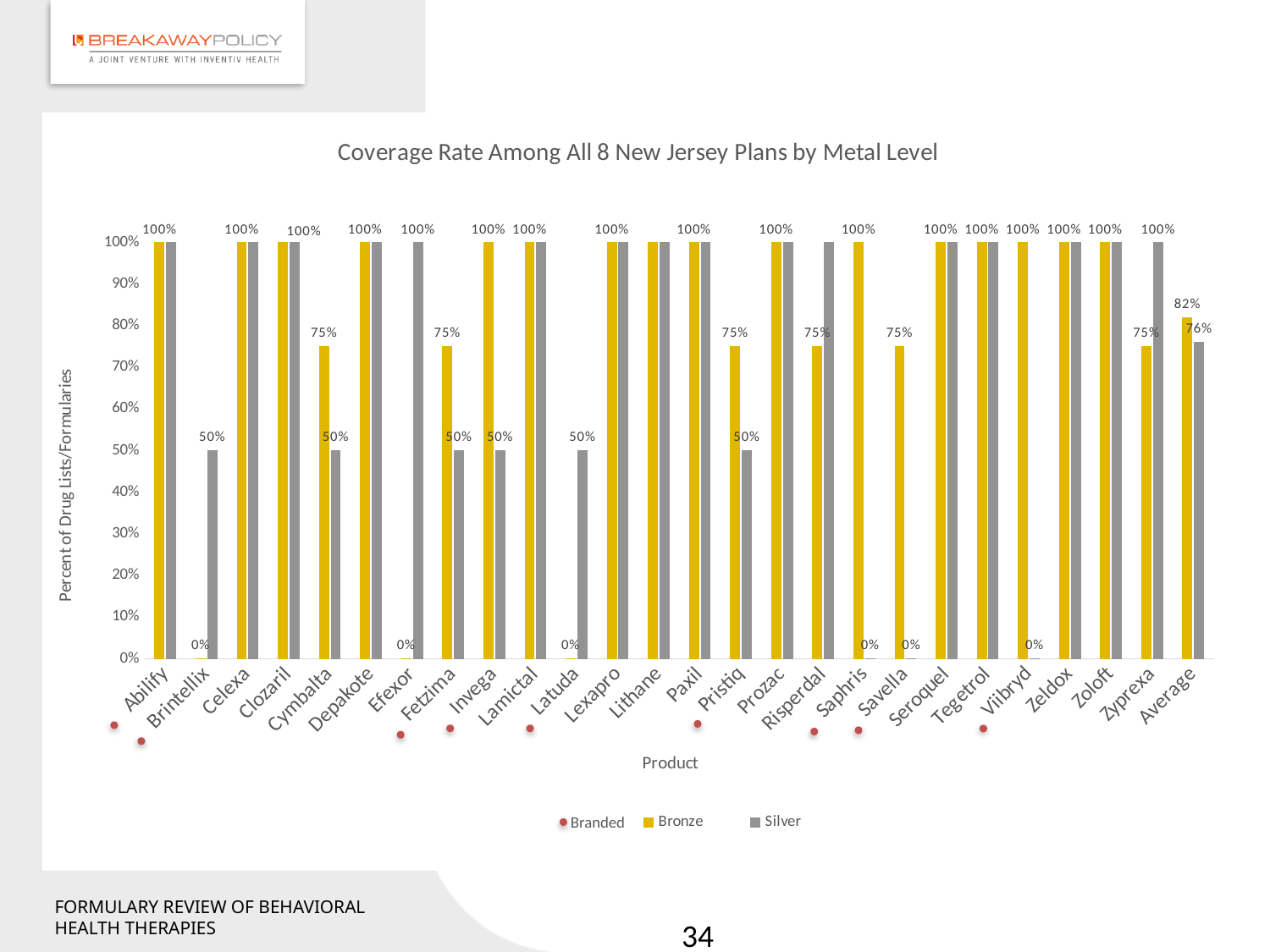
For Efexor, which is larger, the Bronze value or the Silver value? Silver How many product categories are shown on the x axis? 26 What is the Bronze value for Average? 82% What is the difference between the Bronze and Silver values for Cymbalta? 25% What kind of chart is shown on the slide? bar chart What is the difference between the Bronze and Silver values for Average? 6% What is the Silver value for Brintellix? 50% What is the title of the y axis? Percent of Drug Lists/Formularies How many series does the legend list? 3 What is the Bronze value for Cymbalta? 75% What is the Silver value for Saphris? 0% What is the Silver value for Average? 76%